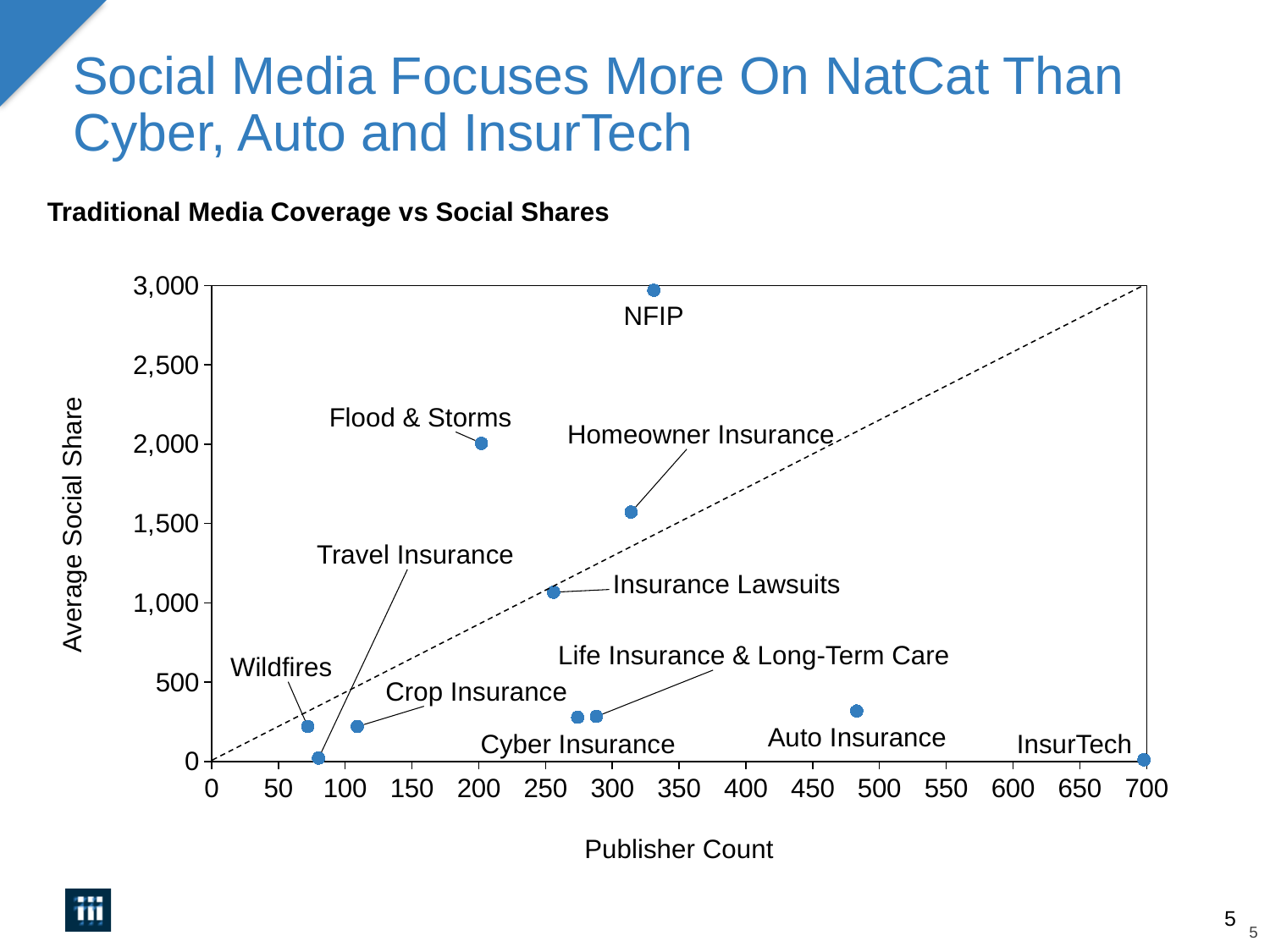
Is the average social share for Auto Insurance greater or less than 500? less What is the title of the x axis? Publisher Count Which topic has the highest publisher count? InsurTech Which has a higher publisher count, Auto Insurance or Cyber Insurance? Auto Insurance What kind of chart is shown on the slide? scatter chart Which topic has the highest average social share? NFIP Is the average social share for Homeowner Insurance greater or less than 1,500? greater How many labeled data points are plotted on the chart? 11 Which has a higher average social share, Flood & Storms or Homeowner Insurance? Flood & Storms Is the publisher count for Flood & Storms greater or less than 250? less What is the title of the y axis? Average Social Share